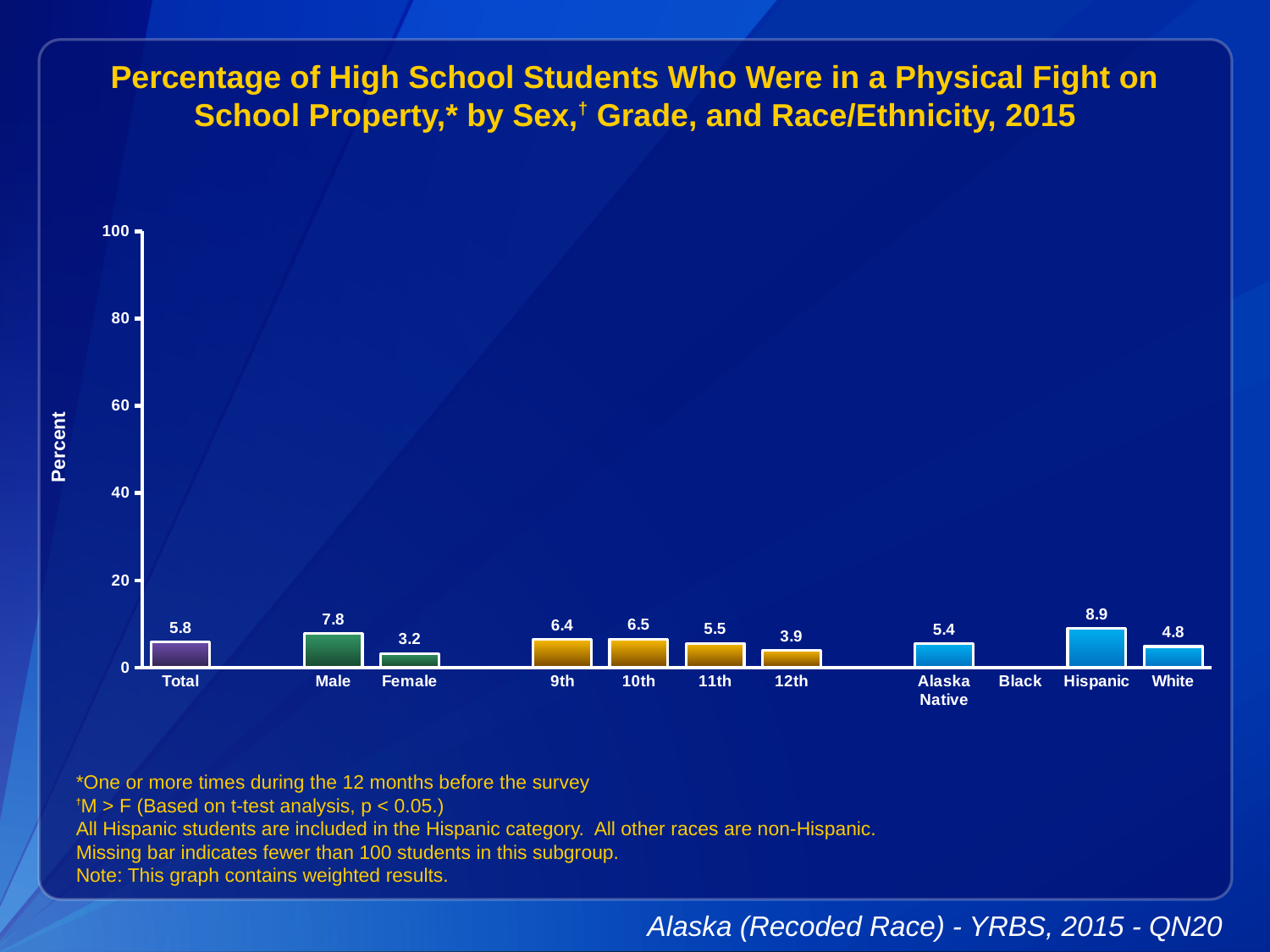
What is the difference between the Male and Female values? 4.6 What kind of chart is shown? bar chart Which category has the highest value? Hispanic What is the value for Male? 7.8 What is the value for Female? 3.2 What is the label on the y axis? Percent What is the value for Total? 5.8 Is the value for Hispanic greater or less than 20? less Which category has no bar shown? Black Which category with a bar has the lowest value? Female What is the value for 12th grade? 3.9 Which is larger, the value for 9th grade or 10th grade? 10th